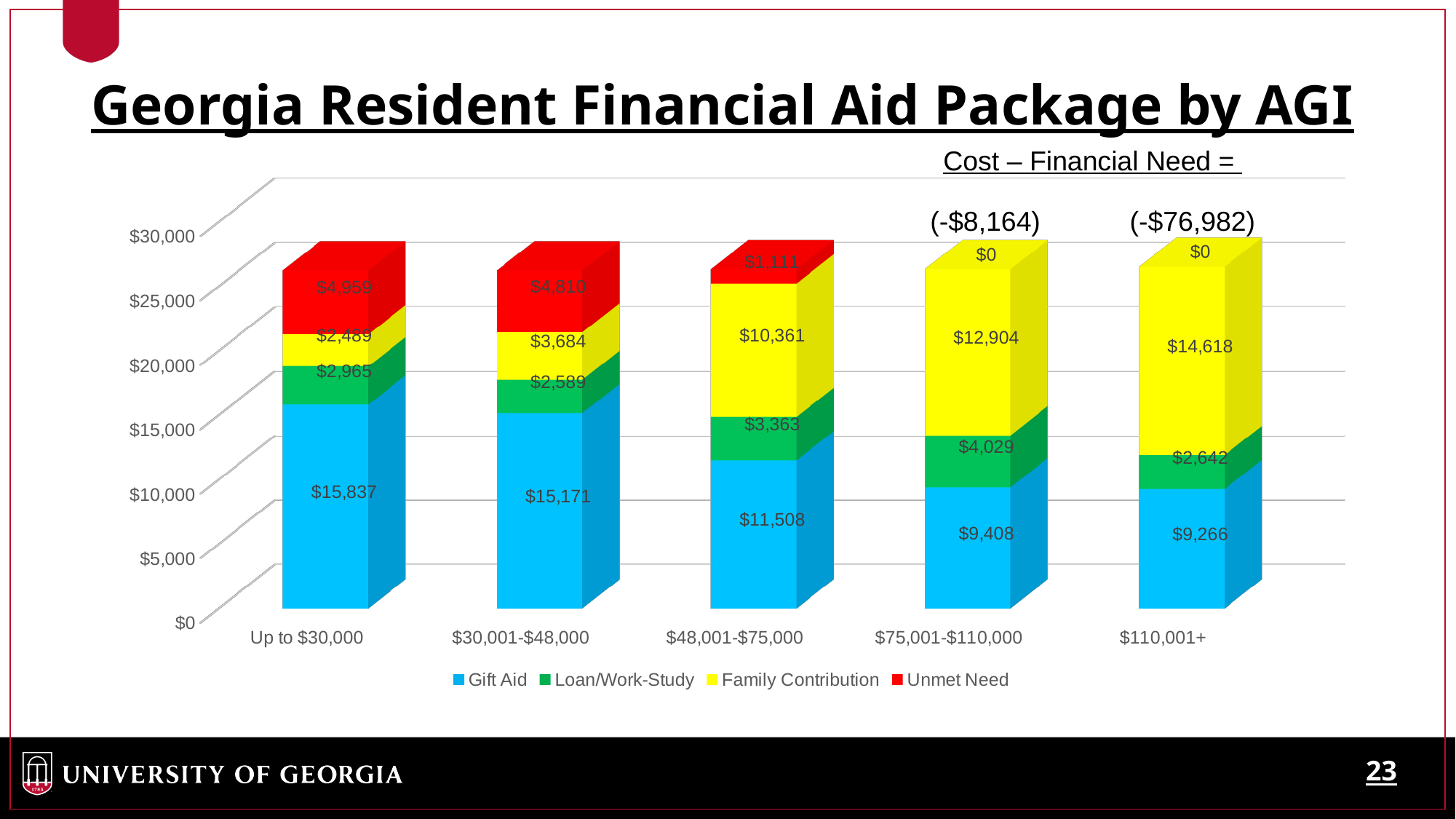
Which is larger: the Unmet Need for Up to $30,000 or for $30,001-$48,000? Up to $30,000 Does the Gift Aid value rise or fall as AGI increases along the x axis? Fall Which AGI category has the lowest Family Contribution value? Up to $30,000 What is the Unmet Need value for the $48,001-$75,000 AGI category? $1,111 What kind of chart is shown on the slide? Stacked bar chart Which AGI category has the highest Gift Aid value? Up to $30,000 What is the Loan/Work-Study value for the $75,001-$110,000 AGI category? $4,029 How many AGI categories are shown on the x axis? 5 What is the difference in Gift Aid between the Up to $30,000 and $30,001-$48,000 categories? $666 What is the Gift Aid value for the Up to $30,000 AGI category? $15,837 How many series does the legend list? 4 What is the Family Contribution value for the $110,001+ AGI category? $14,618